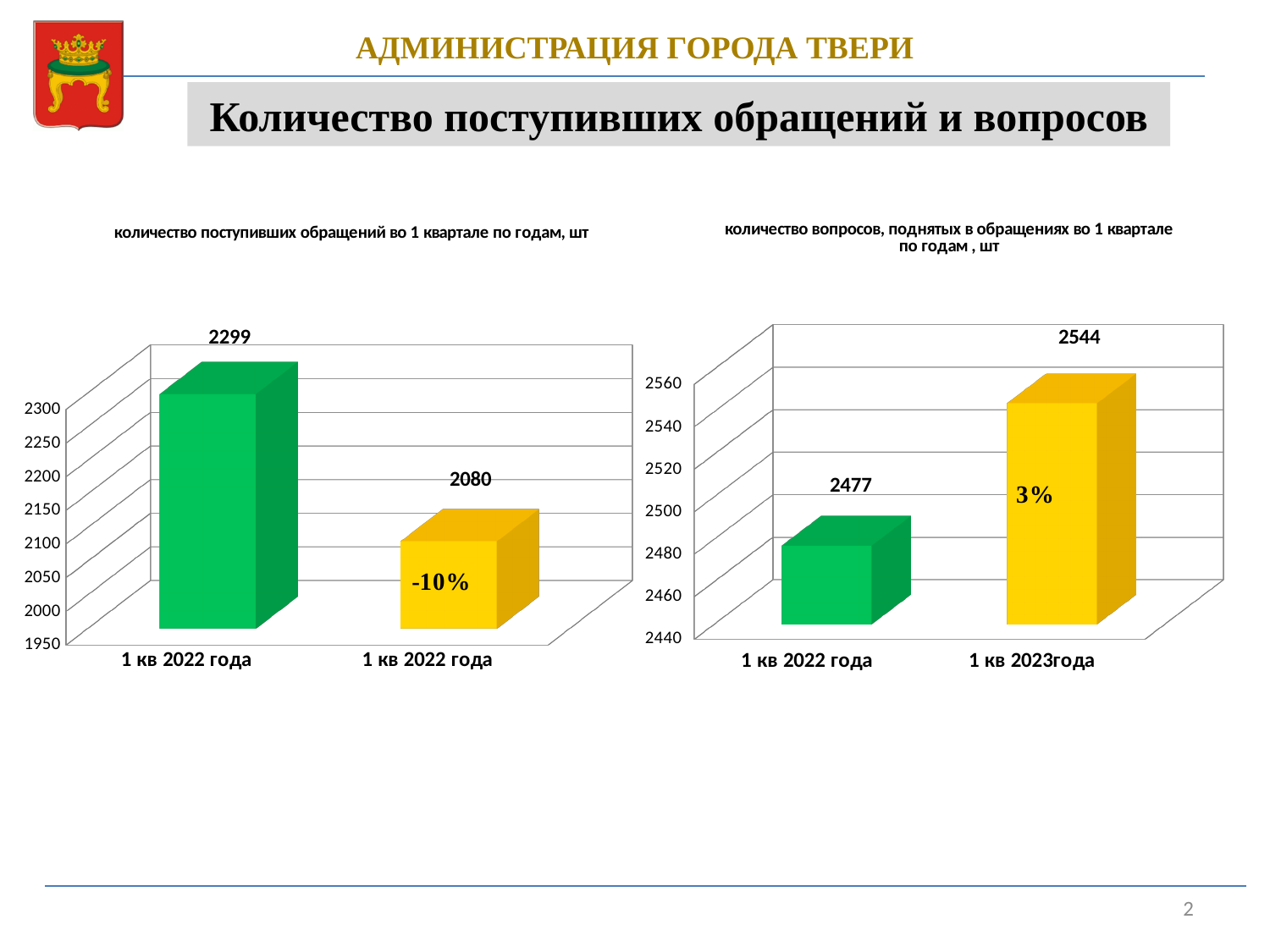
In the left chart (количество поступивших обращений), how many bars are plotted? 2 In the left chart (количество поступивших обращений во 1 квартале по годам, шт), what value is shown on the green bar? 2299 In the left chart (количество поступивших обращений во 1 квартале по годам, шт), what value is shown on the yellow bar? 2080 In the right chart (количество вопросов, поднятых в обращениях), what is the value for 1 кв 2022 года? 2477 In the right chart (количество вопросов, поднятых в обращениях), what percentage change is printed on the yellow bar? 3% In the right chart (количество вопросов, поднятых в обращениях), what is the value for 1 кв 2023года? 2544 In the right chart (количество вопросов, поднятых в обращениях), what is the difference between 1 кв 2023года and 1 кв 2022 года? 67 In the left chart (количество поступивших обращений), what percentage change is printed on the yellow bar? -10% In the left chart (количество поступивших обращений), what is the difference between the green bar and the yellow bar? 219 In the right chart (количество вопросов, поднятых в обращениях), do the values rise or fall from 1 кв 2022 года to 1 кв 2023года? rise What kind of chart is the right chart (количество вопросов, поднятых в обращениях)? bar chart In the right chart (количество вопросов, поднятых в обращениях), which category has the higher value? 1 кв 2023года